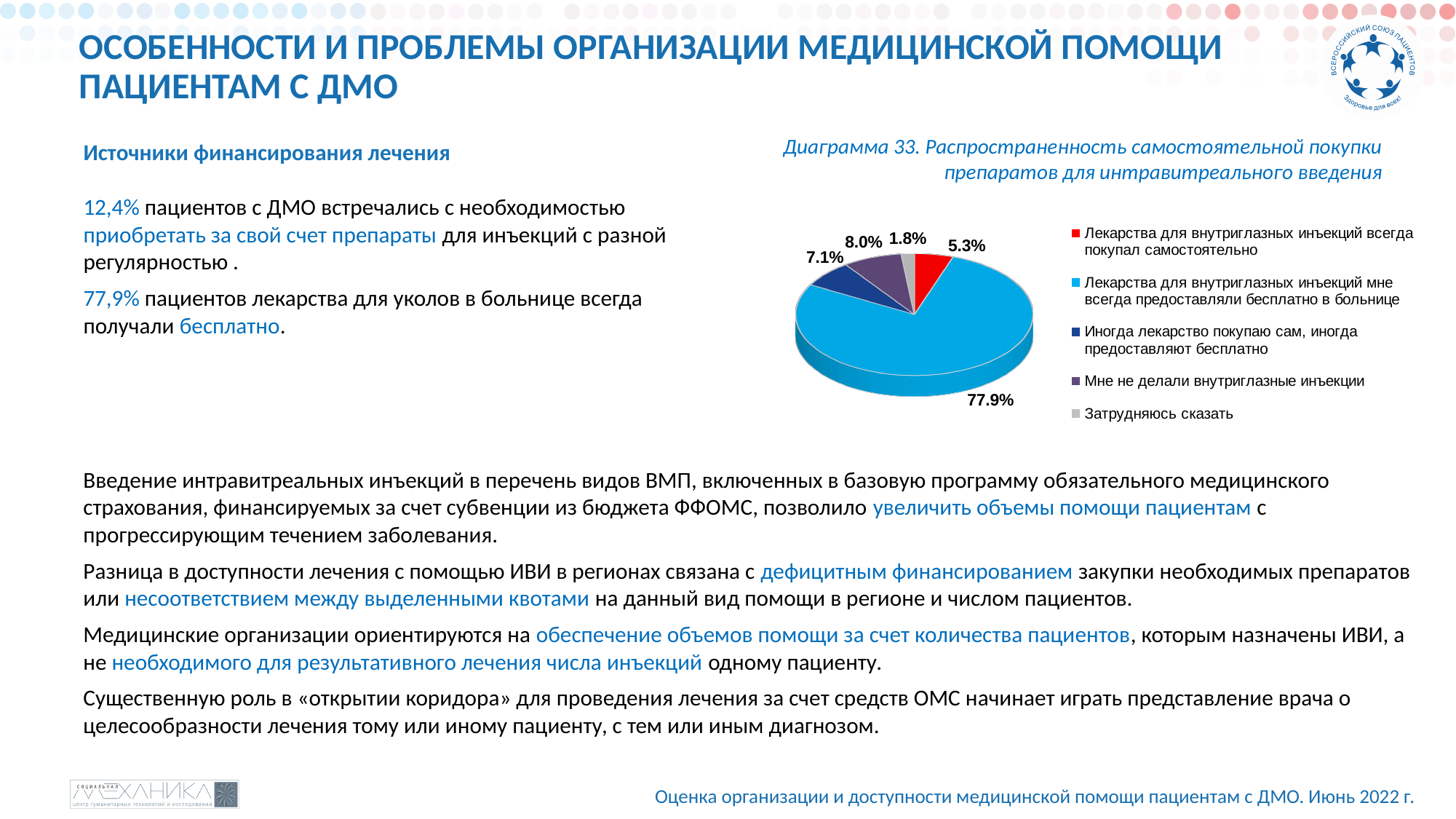
In Диаграмма 33, which category has the smallest share? Затрудняюсь сказать In Диаграмма 33, which is larger: the share for "Мне не делали внутриглазные инъекции" or the share for "Иногда лекарство покупаю сам, иногда предоставляют бесплатно"? Мне не делали внутриглазные инъекции In Диаграмма 33, what colour is the slice for "Лекарства для внутриглазных инъекций всегда покупал самостоятельно"? red In Диаграмма 33, what share corresponds to "Лекарства для внутриглазных инъекций всегда покупал самостоятельно"? 5.3% In Диаграмма 33, what share corresponds to "Затрудняюсь сказать"? 1.8% In Диаграмма 33, how many categories does the legend list? 5 In Диаграмма 33, what share corresponds to "Лекарства для внутриглазных инъекций мне всегда предоставляли бесплатно в больнице"? 77.9% In Диаграмма 33, which category has the largest share? Лекарства для внутриглазных инъекций мне всегда предоставляли бесплатно в больнице In Диаграмма 33, what share corresponds to "Мне не делали внутриглазные инъекции"? 8.0% In Диаграмма 33, what is the difference between the share for "Лекарства для внутриглазных инъекций мне всегда предоставляли бесплатно в больнице" and the share for "Лекарства для внутриглазных инъекций всегда покупал самостоятельно"? 72.6% What type of chart is shown in Диаграмма 33? pie chart In Диаграмма 33, what share corresponds to "Иногда лекарство покупаю сам, иногда предоставляют бесплатно"? 7.1%